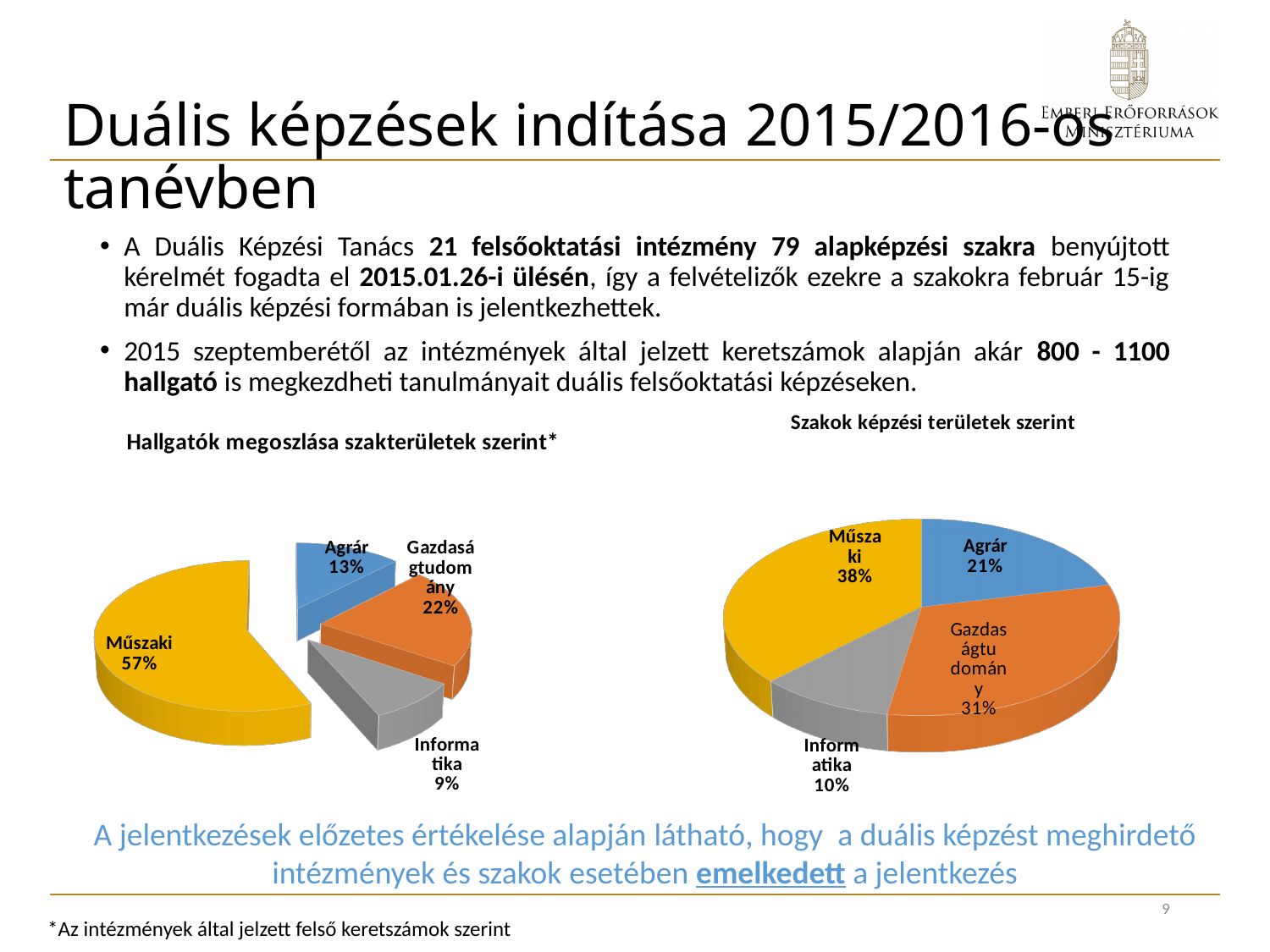
In the chart titled 'Szakok képzési területek szerint', what share does Gazdaságtudomány have? 31% In the chart titled 'Hallgatók megoszlása szakterületek szerint*', what share does Műszaki have? 57% What colour is the Műszaki slice in the chart titled 'Hallgatók megoszlása szakterületek szerint*'? Yellow In the chart titled 'Szakok képzési területek szerint', what share does Agrár have? 21% In the chart titled 'Hallgatók megoszlása szakterületek szerint*', what share does Informatika have? 9% In the chart titled 'Hallgatók megoszlása szakterületek szerint*', what is the difference between the Gazdaságtudomány and Agrár shares? 9% In the chart titled 'Hallgatók megoszlása szakterületek szerint*', which category has the largest slice? Műszaki How many categories does the chart titled 'Hallgatók megoszlása szakterületek szerint*' show? 4 In the chart titled 'Szakok képzési területek szerint', which is larger, Agrár or Informatika? Agrár In the chart titled 'Szakok képzési területek szerint', what is the difference between the Műszaki and Gazdaságtudomány shares? 7% In the chart titled 'Szakok képzési területek szerint', which category has the smallest slice? Informatika What kind of chart is the chart titled 'Szakok képzési területek szerint'? Pie chart